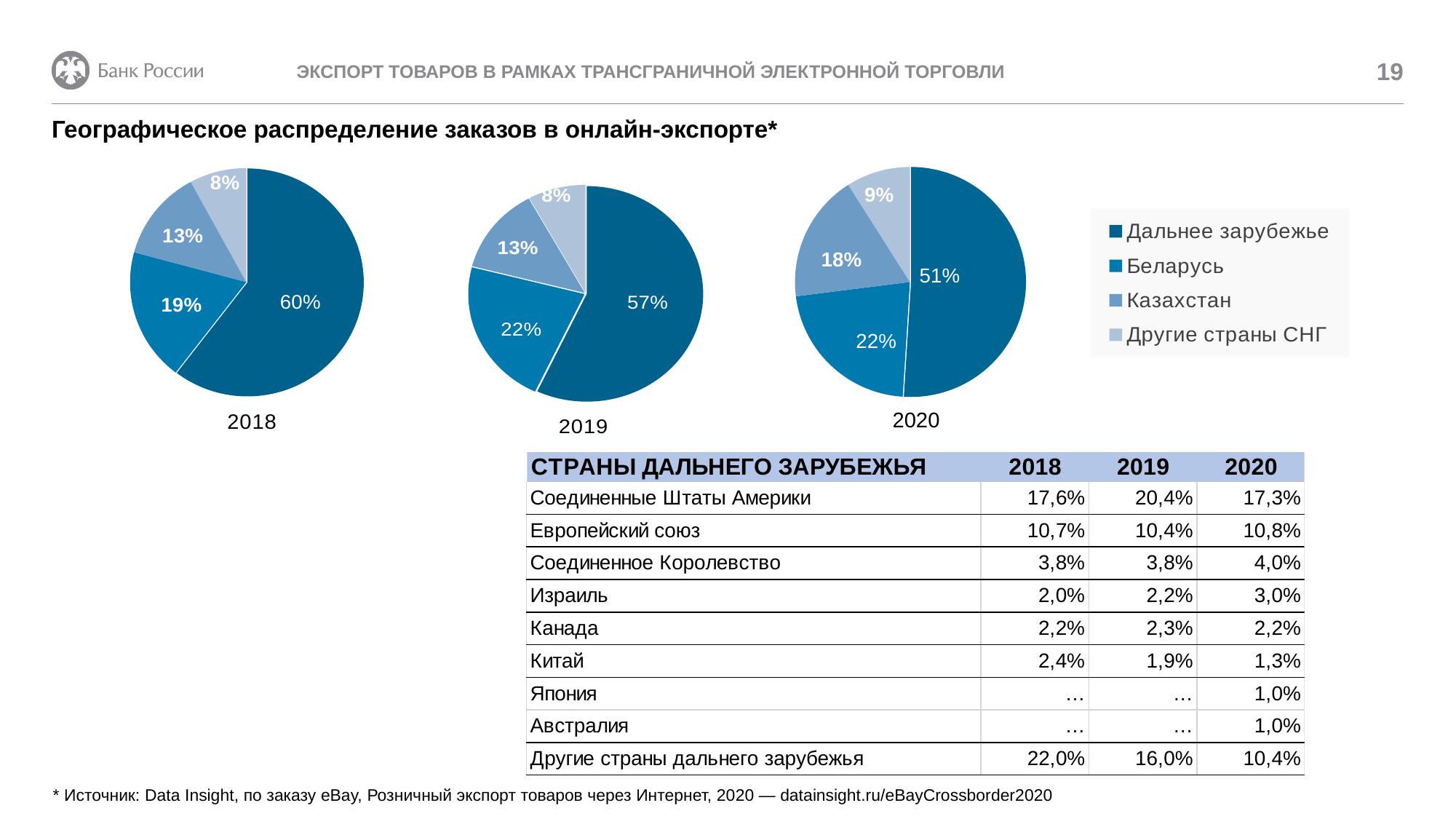
How many categories does the legend of the pie charts list? 4 In the 2019 pie chart, what is the difference between the shares of Дальнее зарубежье and Беларусь? 35 percentage points How does the share of Дальнее зарубежье change across the pie charts from 2018 to 2020? It falls In the 2018 pie chart, what share of orders goes to Дальнее зарубежье? 60% In the 2020 pie chart, which category has the largest slice? Дальнее зарубежье In the 2018 pie chart, which category has the smallest slice? Другие страны СНГ What type of chart is used to show the geographic distribution of orders for each year? Pie chart How many pie charts are shown on the slide? 3 In the 2020 pie chart, what share of orders goes to Казахстан? 18% In the 2020 pie chart, what share of orders goes to Другие страны СНГ? 9% In the 2019 pie chart, what share of orders goes to Беларусь? 22% In the 2020 pie chart, which is larger: the share of Беларусь or the share of Казахстан? Беларусь